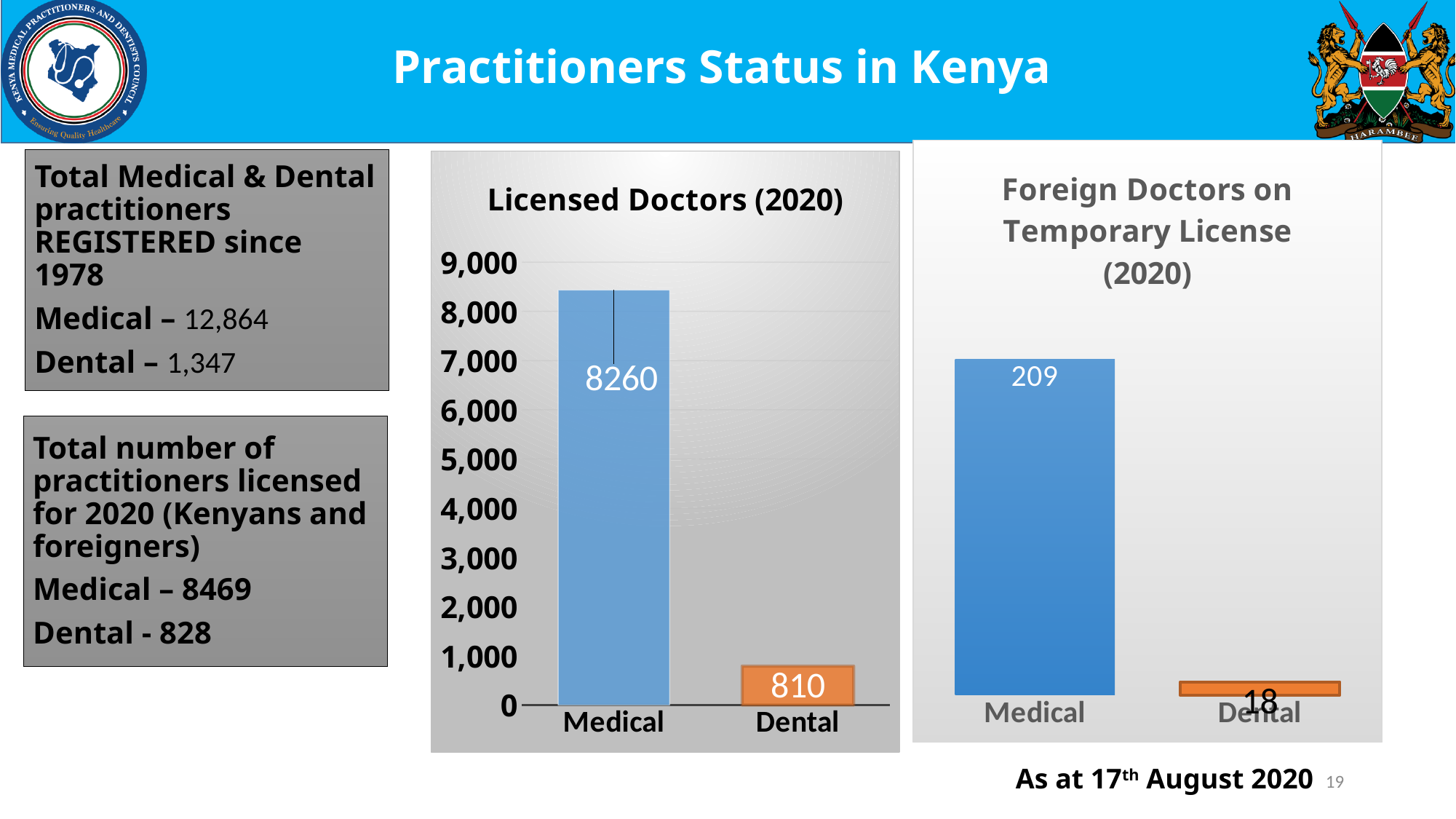
In the 'Foreign Doctors on Temporary License (2020)' chart, what is the value for Medical? 209 In the 'Licensed Doctors (2020)' chart, what colour is the Dental bar? orange In the 'Foreign Doctors on Temporary License (2020)' chart, what is the difference between the Medical and Dental values? 191 In the 'Foreign Doctors on Temporary License (2020)' chart, which category has the lowest value? Dental In the 'Licensed Doctors (2020)' chart, what is the value for Medical? 8260 In the 'Licensed Doctors (2020)' chart, which category has the highest value? Medical In the 'Licensed Doctors (2020)' chart, what is the difference between the Medical and Dental values? 7450 How many categories are shown in the 'Licensed Doctors (2020)' chart? 2 In the 'Foreign Doctors on Temporary License (2020)' chart, what is the value for Dental? 18 What kind of chart is the 'Foreign Doctors on Temporary License (2020)' chart? bar chart In the 'Licensed Doctors (2020)' chart, what is the value for Dental? 810 In the 'Licensed Doctors (2020)' chart, is the value for Dental greater or less than 1,000? less